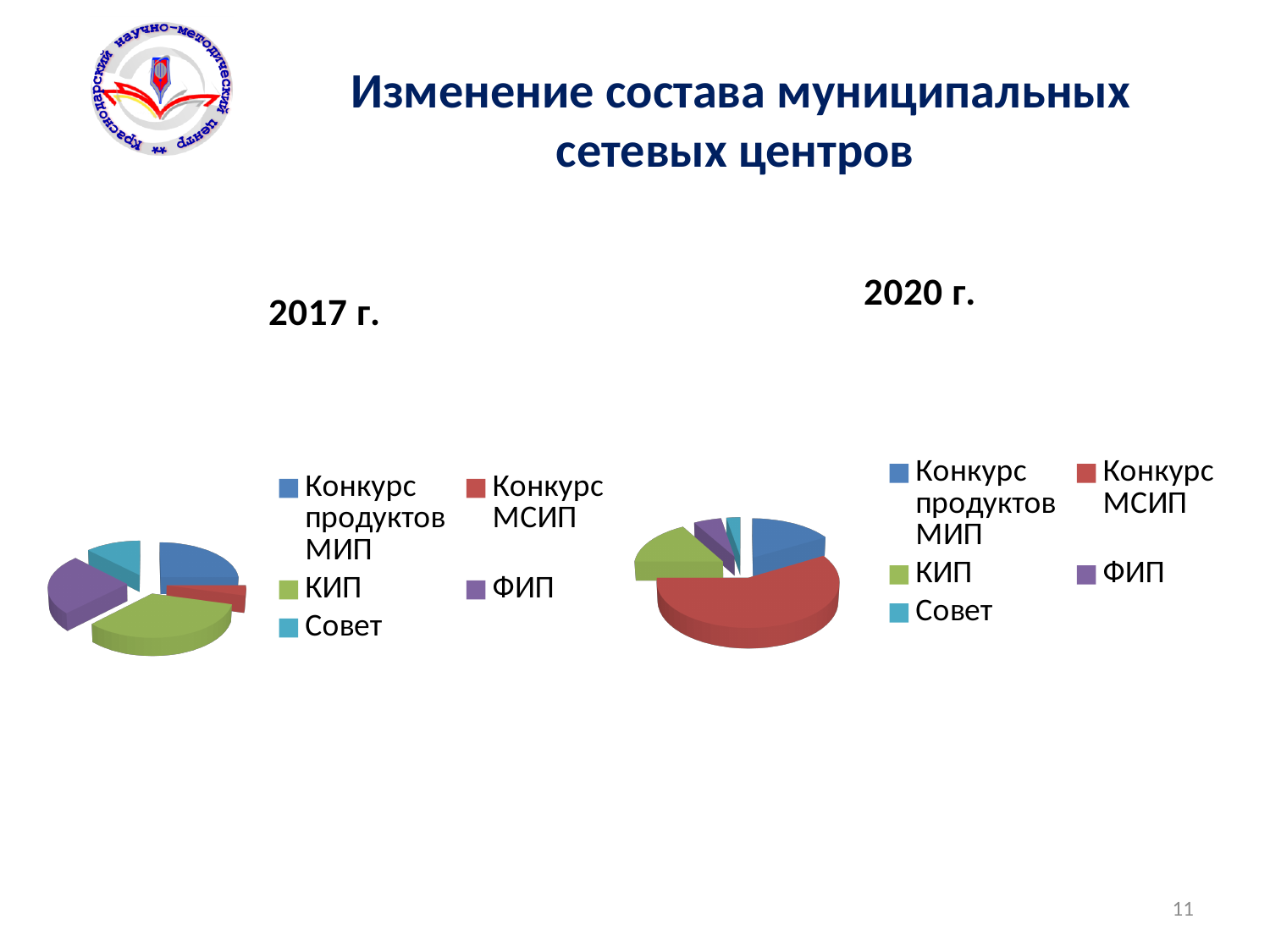
What kind of chart is the 2020 г. chart? pie chart How many slices does the 2017 г. pie chart have? 5 In the 2020 г. chart, which slice is larger: Конкурс МСИП or КИП? Конкурс МСИП In the 2017 г. chart, which category has the smallest slice? Конкурс МСИП In the 2020 г. chart, which slice is larger: Конкурс продуктов МИП or Совет? Конкурс продуктов МИП What colour represents ФИП in the legend of the 2017 г. chart? purple How many entries does the legend of the 2020 г. chart list? 5 What kind of chart is the 2017 г. chart? pie chart In the 2017 г. chart, which category has the largest slice? КИП What is the title of the slide containing the two pie charts? Изменение состава муниципальных сетевых центров In the 2017 г. chart, which slice is larger: КИП or Совет? КИП In the 2020 г. chart, which category has the largest slice? Конкурс МСИП